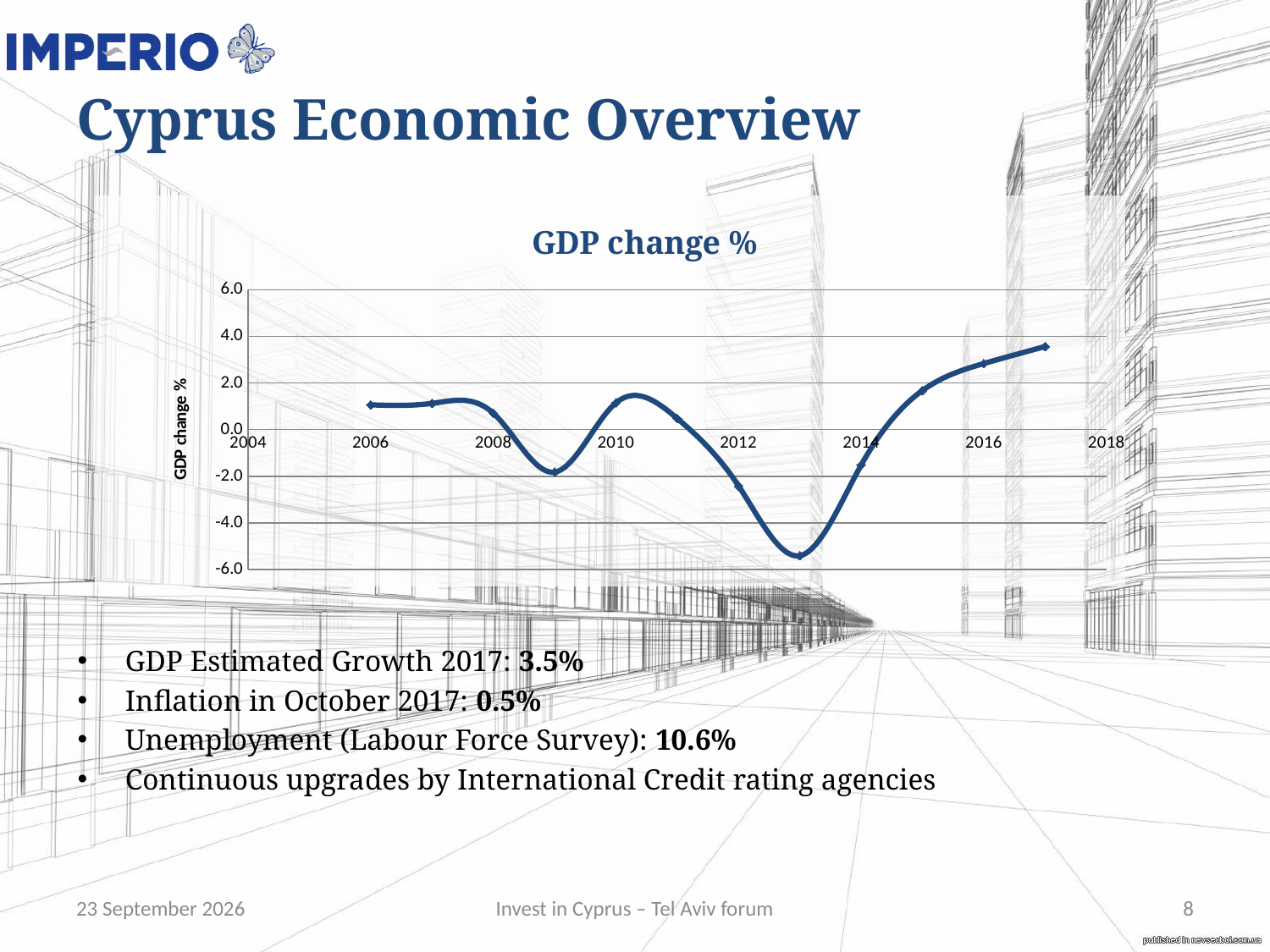
Does the GDP change % line rise or fall between 2010 and 2013? fall In which year does the GDP change % line reach its highest point? 2017 Is the GDP change % value for 2013 greater or less than -4.0? less Is the GDP change % value for 2017 greater or less than 2.0? greater Is the GDP change % value for 2016 greater or less than 2.0? greater Does the GDP change % line rise or fall between 2013 and 2017? rise What kind of chart is shown on the slide? line chart What is the label on the vertical axis of the chart? GDP change % Which year has the larger GDP change %, 2016 or 2009? 2016 In which year does the GDP change % line reach its lowest point? 2013 What is the title of the chart? GDP change %